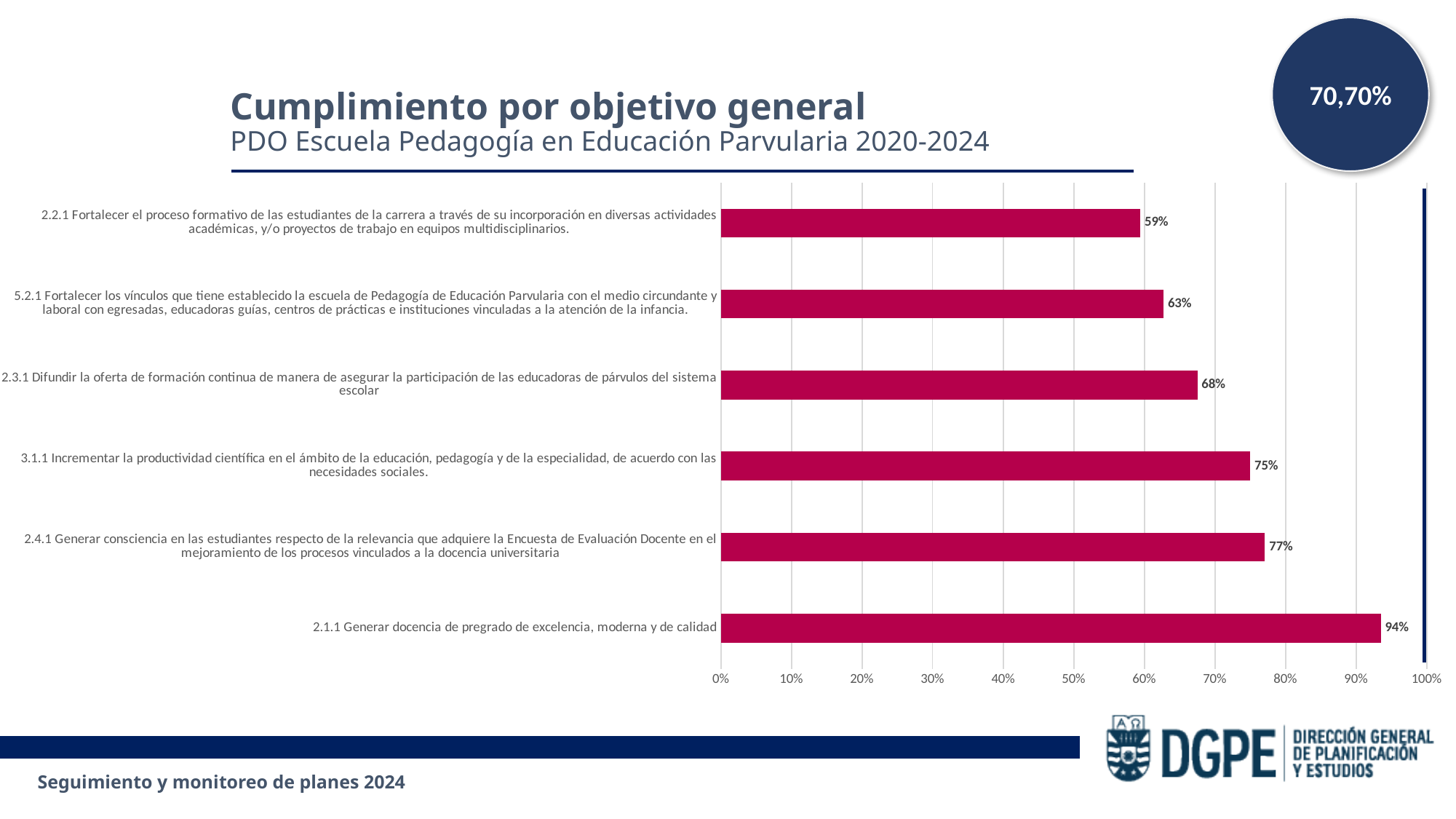
What kind of chart is shown on the slide? Bar chart What is the value for objective 2.2.1 (Fortalecer el proceso formativo de las estudiantes)? 59% Which has a larger value, objective 2.4.1 or objective 5.2.1? 2.4.1 What is the value for objective 3.1.1 (Incrementar la productividad científica)? 75% Which objective has the highest compliance value? 2.1.1 Generar docencia de pregrado de excelencia, moderna y de calidad How many objectives are shown in the chart? 6 What is the value for objective 2.1.1 (Generar docencia de pregrado de excelencia, moderna y de calidad)? 94% What is the difference between the values for objective 2.1.1 and objective 2.2.1? 35% What overall percentage is shown in the circle at the top right of the slide? 70,70% Is the value for objective 5.2.1 greater or less than 70%? less What is the value for objective 2.3.1 (Difundir la oferta de formación continua)? 68% Which objective has the lowest compliance value? 2.2.1 Fortalecer el proceso formativo de las estudiantes de la carrera